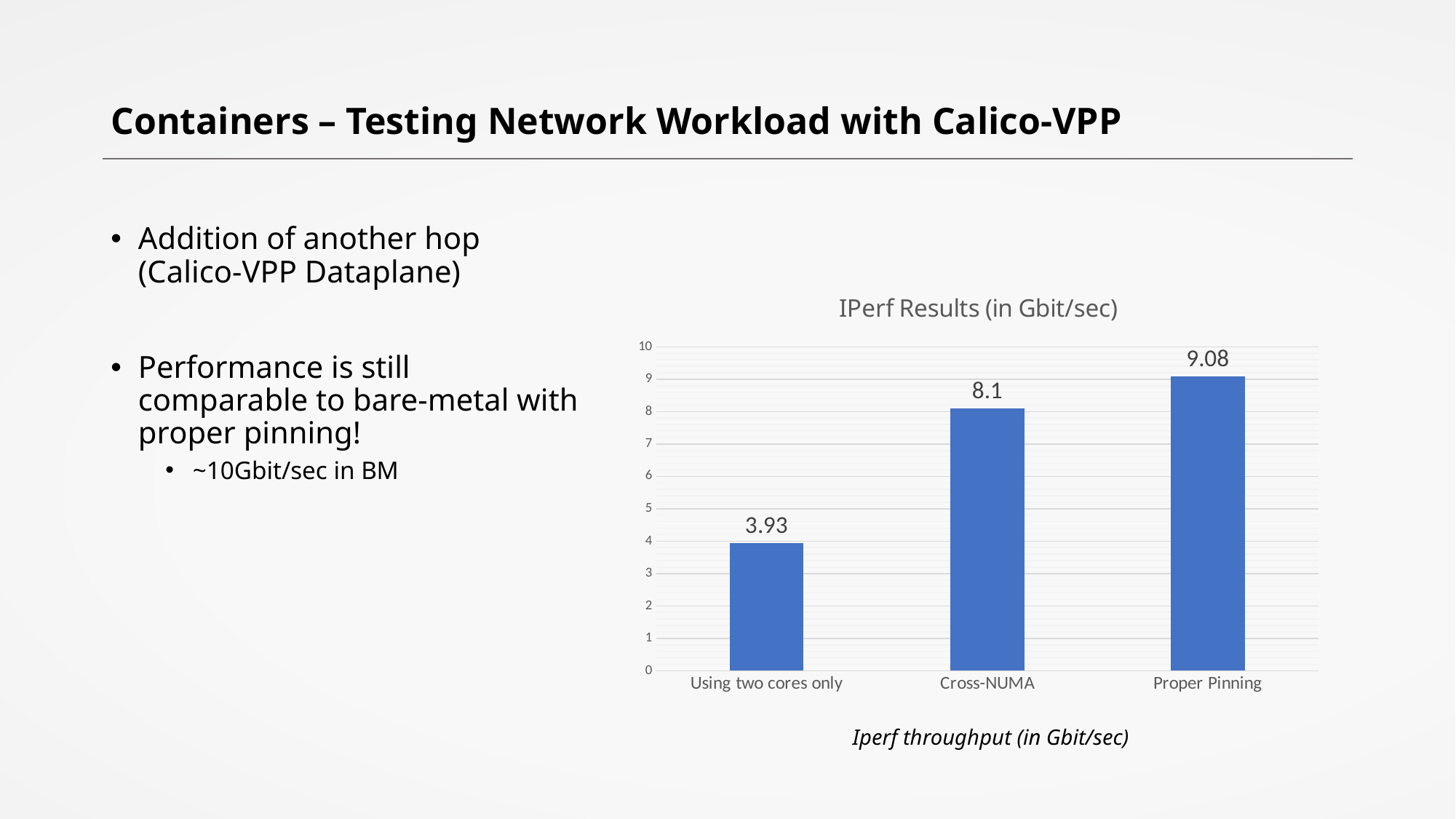
What is the difference between the Proper Pinning and Cross-NUMA IPerf results? 0.98 Which category has the highest IPerf result? Proper Pinning What is the title of the chart? IPerf Results (in Gbit/sec) What is the IPerf result for Proper Pinning? 9.08 What is the IPerf result for Cross-NUMA? 8.1 Is the value for Using two cores only greater or less than 4? less Which is larger, the IPerf result for Cross-NUMA or for Using two cores only? Cross-NUMA What kind of chart is shown on the slide? bar chart How many categories are shown in the chart? 3 What is the IPerf result for Using two cores only? 3.93 What is the difference between the Cross-NUMA and Using two cores only IPerf results? 4.17 Which category has the lowest IPerf result? Using two cores only